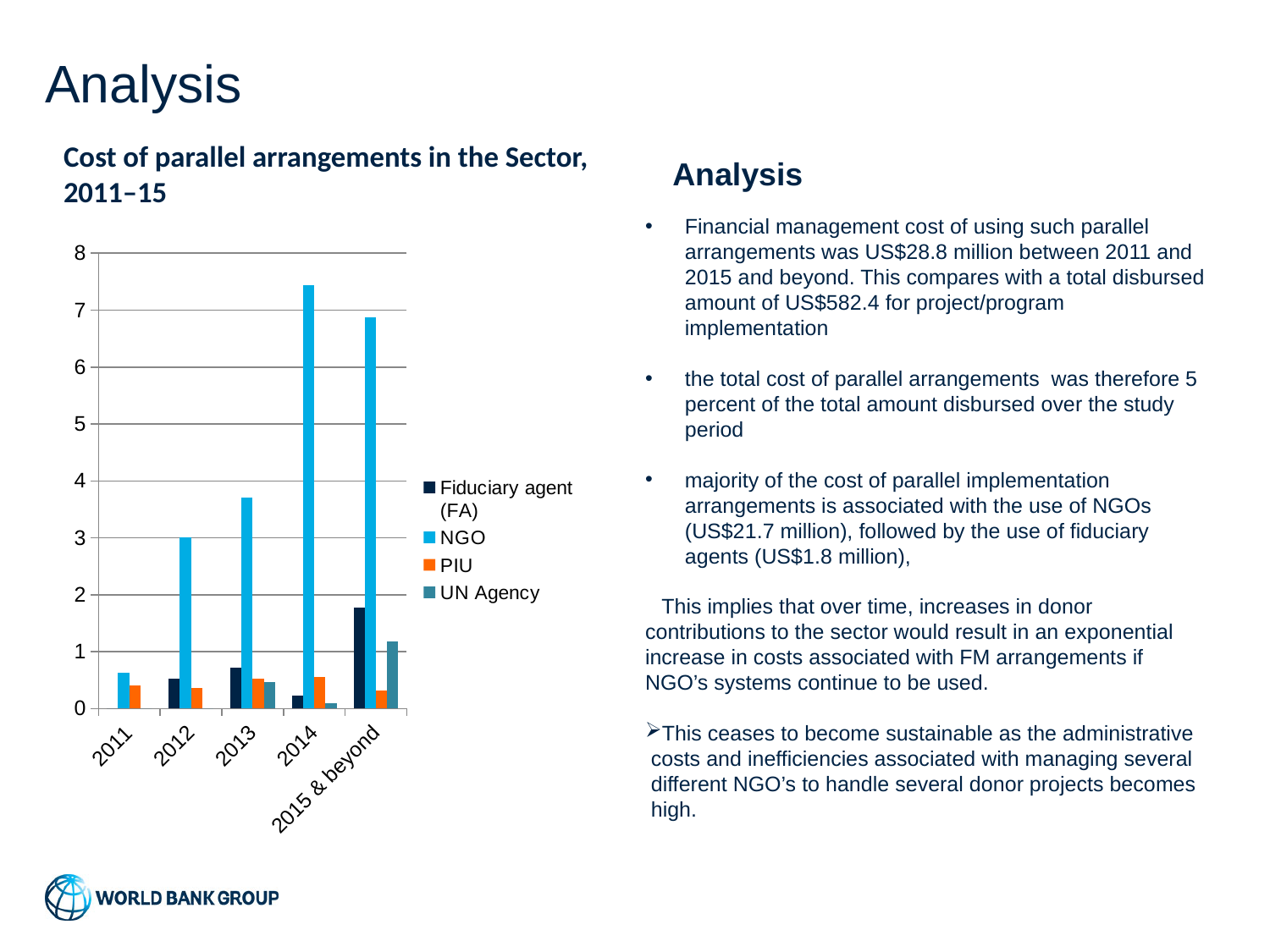
Do the NGO values rise or fall from 2011 to 2014? rise Which is larger, the NGO value for 2014 or the NGO value for 2015 & beyond? 2014 Is the NGO value for 2014 greater or less than 7? greater Is the Fiduciary agent (FA) value for 2015 & beyond greater or less than 2? less Which series has the tallest bar in 2015 & beyond? NGO What kind of chart is shown on the slide? bar chart How many series does the chart legend list? 4 What is the title of the chart? Cost of parallel arrangements in the Sector, 2011-15 In which year is the NGO value highest? 2014 Is the NGO value for 2013 greater or less than 3? greater How many categories are shown on the x axis of the chart? 5 In which year is the NGO value lowest? 2011